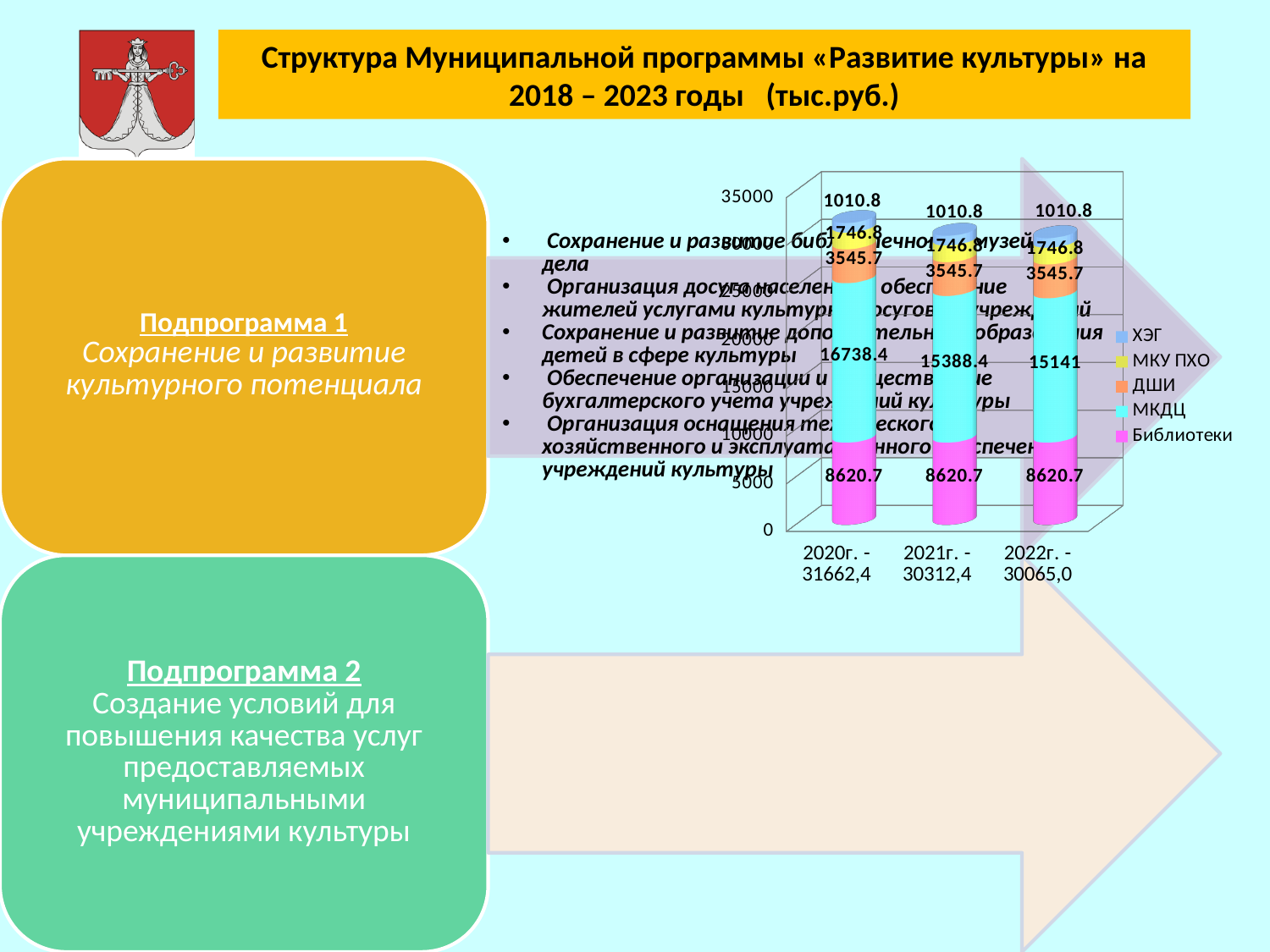
What kind of chart is shown on the slide? stacked bar chart What is the value for ДШИ in 2022? 3545.7 What is the value for МКДЦ in 2020? 16738.4 What is the total of the stacked bar for 2022, as printed in its category label? 30065,0 How many year categories are plotted on the x axis of the chart? 3 What is the difference between the МКДЦ values for 2020 and 2021? 1350 How many series does the chart legend list? 5 What is the value for ХЭГ in 2020? 1010.8 In which year is the value for МКДЦ the highest? 2020 What is the value for МКДЦ in 2022? 15141 Which is larger in 2021: the value for ДШИ or the value for МКУ ПХО? ДШИ What is the value for Библиотеки in 2021? 8620.7